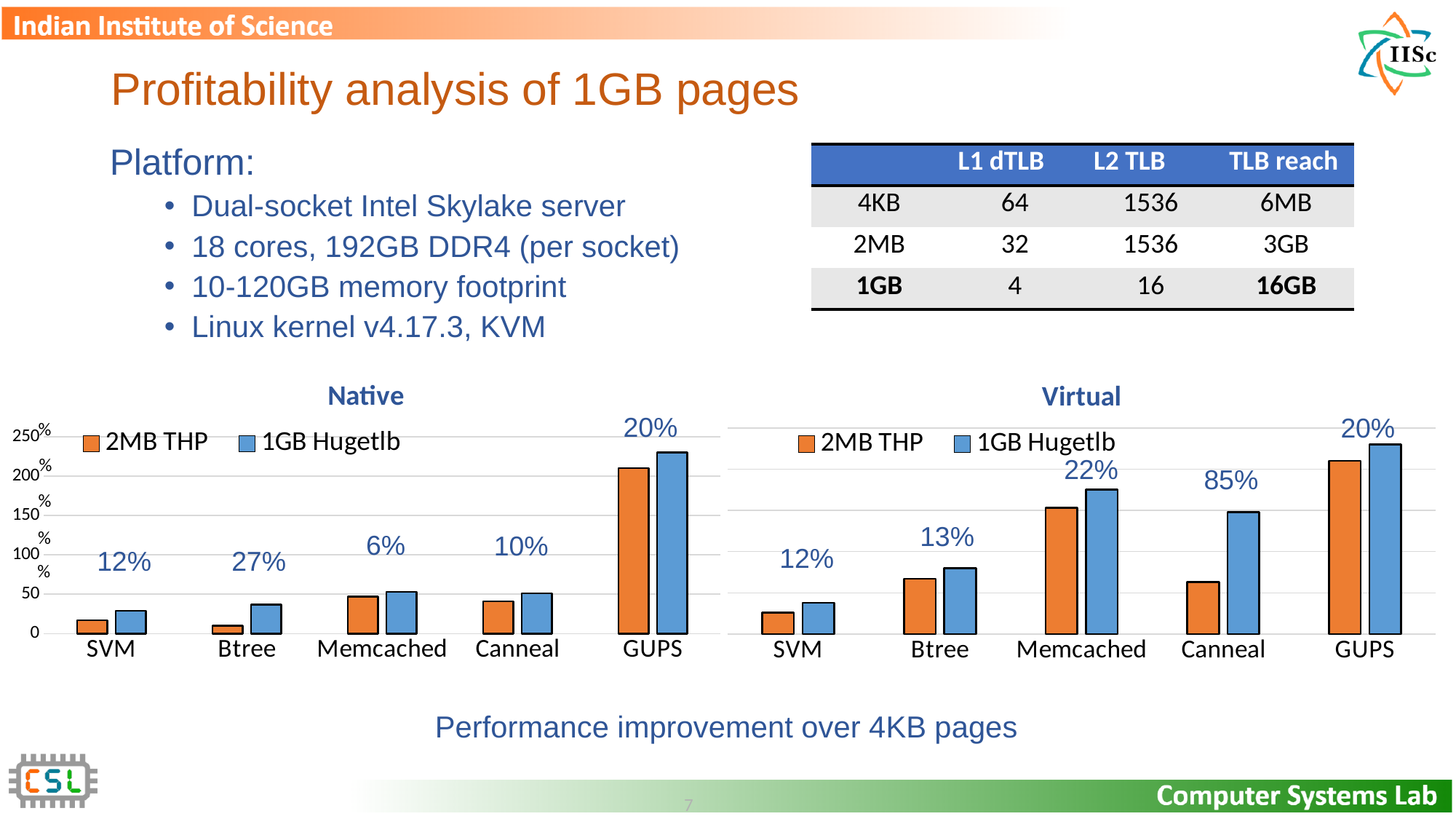
How many categories are shown on the x axis of the Native chart? 5 In the Virtual chart, is the 1GB Hugetlb bar for Memcached larger or smaller than the 1GB Hugetlb bar for Canneal? larger Which series is drawn in orange in the Native chart? 2MB THP In the Native chart, which category has the lowest 2MB THP bar? Btree What percentage is annotated above the Canneal bars in the Virtual chart? 85% In the Virtual chart, is the 1GB Hugetlb value for Memcached greater or less than 150%? greater What kind of chart is the Native chart? bar chart In the Native chart, which category has the highest 1GB Hugetlb bar? GUPS In the Native chart, is the 2MB THP value for SVM greater or less than 50%? less In the Native chart, is the 2MB THP value for GUPS greater or less than 200%? greater In the Virtual chart, which category has the lowest 2MB THP bar? SVM How many series does the legend of the Virtual chart list? 2